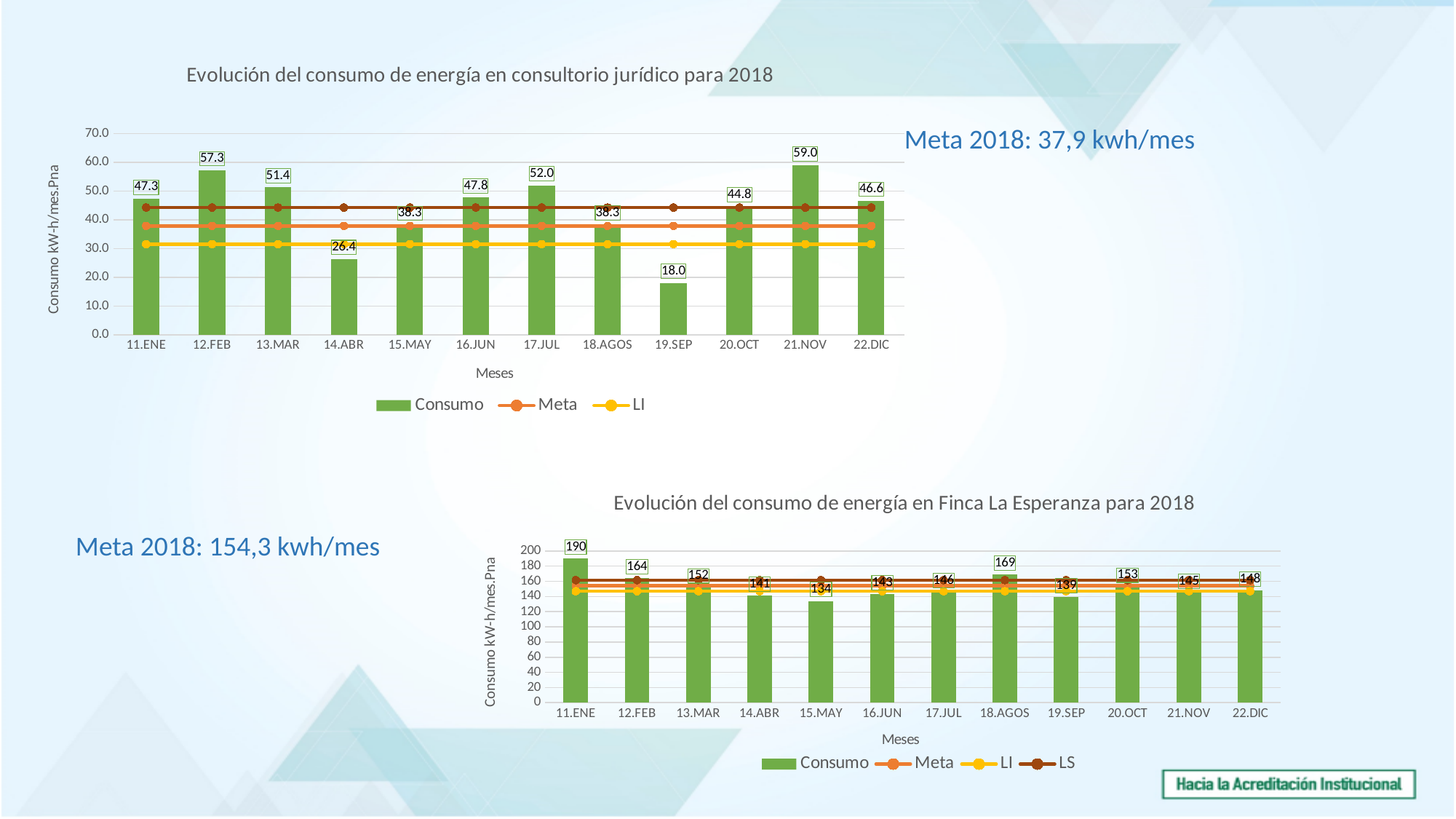
In the chart 'Evolución del consumo de energía en consultorio jurídico para 2018', which month has the lowest Consumo value? 19.SEP In the chart 'Evolución del consumo de energía en consultorio jurídico para 2018', which month has the highest Consumo value? 21.NOV In the chart 'Evolución del consumo de energía en consultorio jurídico para 2018', what is the difference between the Consumo values for 12.FEB and 14.ABR? 30.9 In the chart 'Evolución del consumo de energía en Finca La Esperanza para 2018', how many months are shown on the x axis? 12 In the chart 'Evolución del consumo de energía en Finca La Esperanza para 2018', which is larger, the Consumo value for 18.AGOS or for 20.OCT? 18.AGOS In the chart 'Evolución del consumo de energía en Finca La Esperanza para 2018', which month has the lowest Consumo value? 15.MAY In the chart 'Evolución del consumo de energía en consultorio jurídico para 2018', how many series does the legend list? 3 What kind of chart is 'Evolución del consumo de energía en Finca La Esperanza para 2018'? Bar chart with line series In the chart 'Evolución del consumo de energía en Finca La Esperanza para 2018', how many series does the legend list? 4 In the chart 'Evolución del consumo de energía en consultorio jurídico para 2018', what is the Consumo value for 21.NOV? 59.0 In the chart 'Evolución del consumo de energía en consultorio jurídico para 2018', is the Consumo value for 19.SEP greater or less than 20.0? less In the chart 'Evolución del consumo de energía en Finca La Esperanza para 2018', what is the Consumo value for 11.ENE? 190